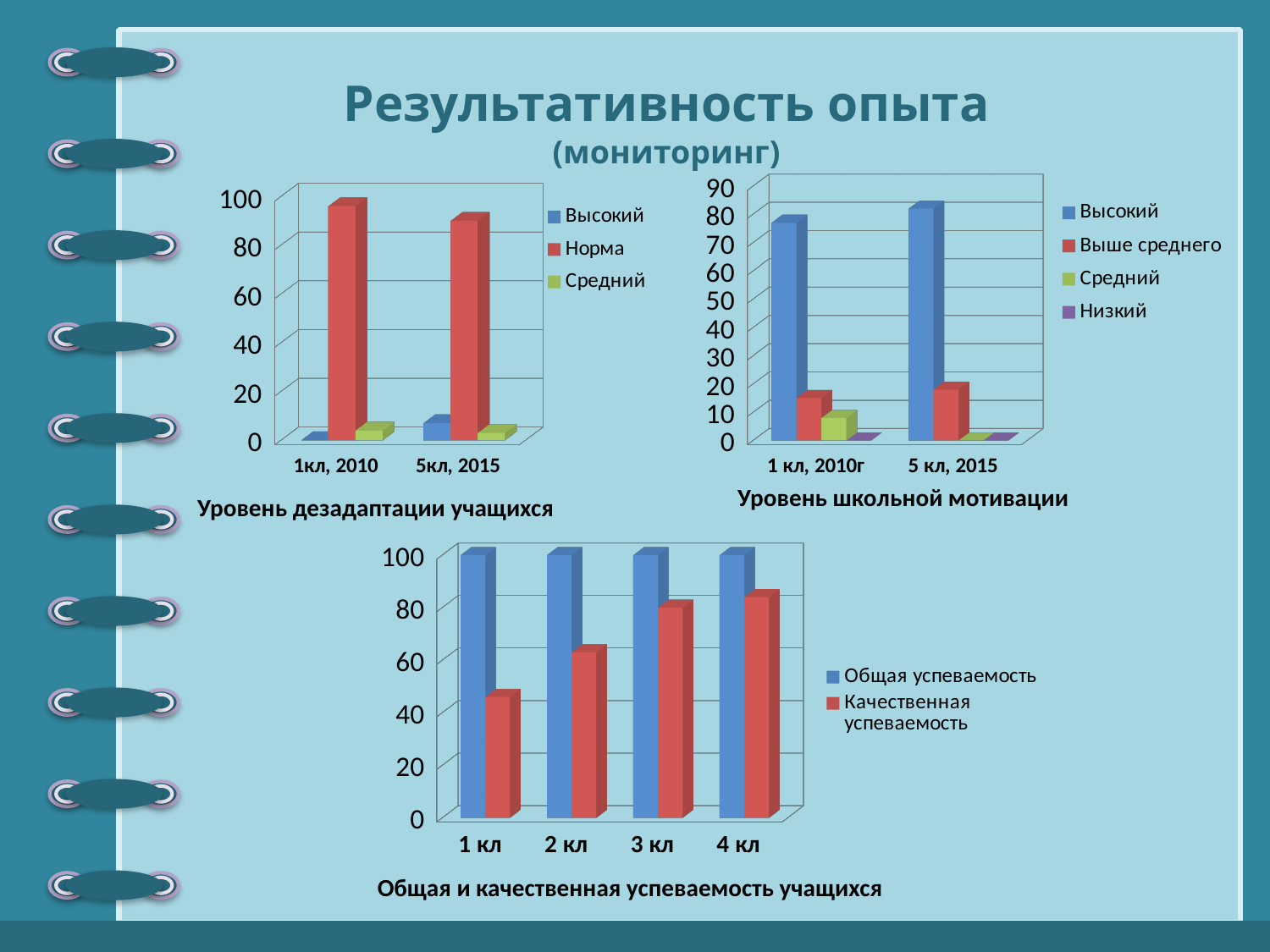
In the bottom chart 'Общая и качественная успеваемость учащихся', does 'Качественная успеваемость' rise or fall from '1 кл' to '4 кл'? rise In the top-left chart 'Уровень дезадаптации учащихся', which series has the highest value for '1кл, 2010'? Норма In the top-right chart 'Уровень школьной мотивации', is the value of 'Высокий' for '1 кл, 2010г' greater or less than 50? greater What kind of chart is the bottom chart titled 'Общая и качественная успеваемость учащихся'? bar chart In the top-left chart 'Уровень дезадаптации учащихся', what are the three legend entries? Высокий, Норма, Средний In the bottom chart 'Общая и качественная успеваемость учащихся', is the value of 'Качественная успеваемость' for '1 кл' greater or less than 60? less In the bottom chart 'Общая и качественная успеваемость учащихся', how many series does the legend list? 2 In the top-right chart 'Уровень школьной мотивации', which is larger for '5 кл, 2015': 'Высокий' or 'Выше среднего'? Высокий In the bottom chart 'Общая и качественная успеваемость учащихся', what is the value of 'Общая успеваемость' for '1 кл'? 100 In the top-right chart 'Уровень школьной мотивации', how many series does the legend list? 4 In the bottom chart 'Общая и качественная успеваемость учащихся', how many categories are shown on the x axis? 4 In the bottom chart 'Общая и качественная успеваемость учащихся', is the value of 'Качественная успеваемость' for '4 кл' greater or less than 60? greater